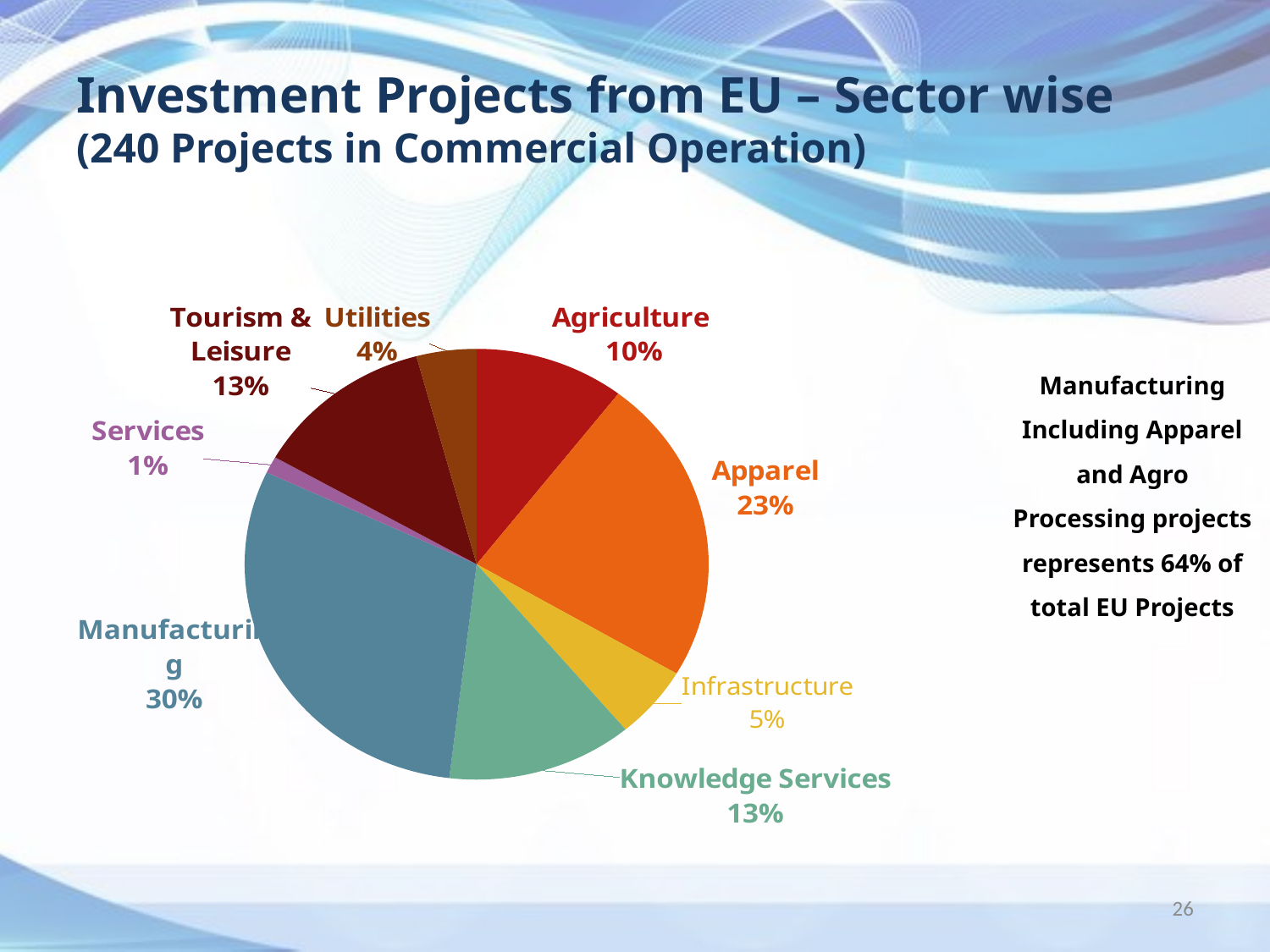
How many sectors are shown in the pie chart? 8 What is the difference in percentage points between Manufacturing and Apparel? 7 What is the value shown for Infrastructure? 5% What is the combined share of Tourism & Leisure and Knowledge Services? 26% What share of the pie does Apparel represent? 23% Which sector has the smallest share of the pie? Services What kind of chart is shown on the slide? Pie chart What is the value shown for Utilities? 4% What share of the pie does Manufacturing represent? 30% Which sector has the largest share of the pie? Manufacturing What is the value shown for Agriculture? 10% Which is larger, the share for Agriculture or the share for Infrastructure? Agriculture